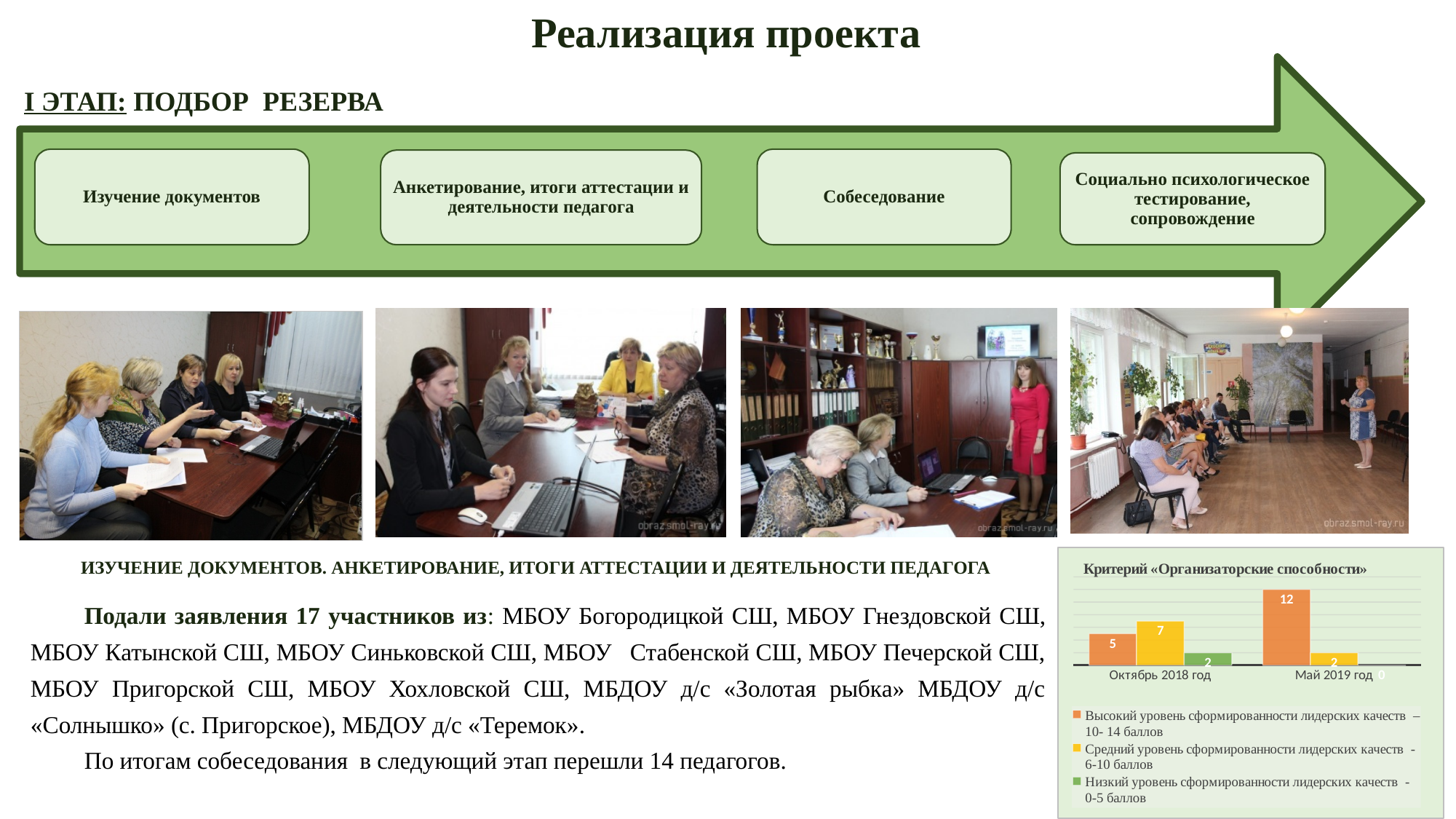
How many series does the chart legend list? 3 What is the title of the chart on the slide? Критерий «Организаторские способности» What kind of chart is shown on the slide? bar chart What is the value of the high level series (Высокий уровень) for Октябрь 2018 год? 5 What is the difference between the high level value for Май 2019 год and for Октябрь 2018 год? 7 What is the value of the low level series (Низкий уровень) for Май 2019 год? 0 Does the high level series (Высокий уровень) rise or fall from Октябрь 2018 год to Май 2019 год? rise Which series has the highest value for Май 2019 год? Высокий уровень сформированности лидерских качеств What is the value of the medium level series (Средний уровень) for Октябрь 2018 год? 7 How many categories are shown on the x axis of the chart? 2 What is the value of the high level series (Высокий уровень) for Май 2019 год? 12 Which series has the lowest value for Октябрь 2018 год? Низкий уровень сформированности лидерских качеств